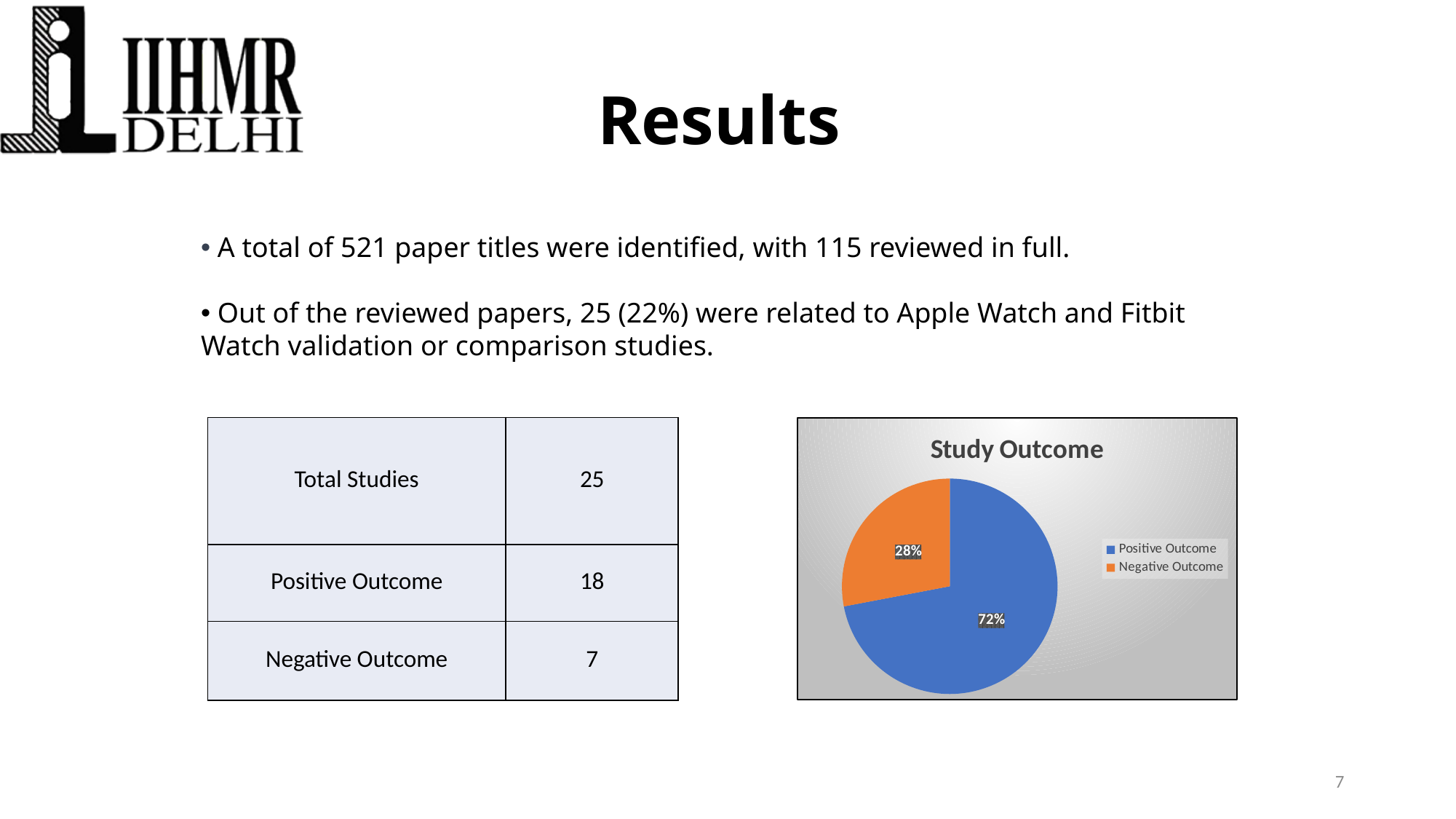
What colour is the Negative Outcome slice? Orange Which slice of the pie is the largest? Positive Outcome How many slices does the pie chart have? 2 What percentage of the pie is Positive Outcome? 72% Which slice of the pie is the smallest? Negative Outcome What is the share of the pie taken by the Positive Outcome slice? 72% What is the title of the chart? Study Outcome What type of chart is shown on the slide? Pie chart What percentage of the pie is Negative Outcome? 28% What is the difference in percentage points between the Positive Outcome and Negative Outcome slices? 44 How many entries does the legend list? 2 Which is larger, the Positive Outcome slice or the Negative Outcome slice? Positive Outcome